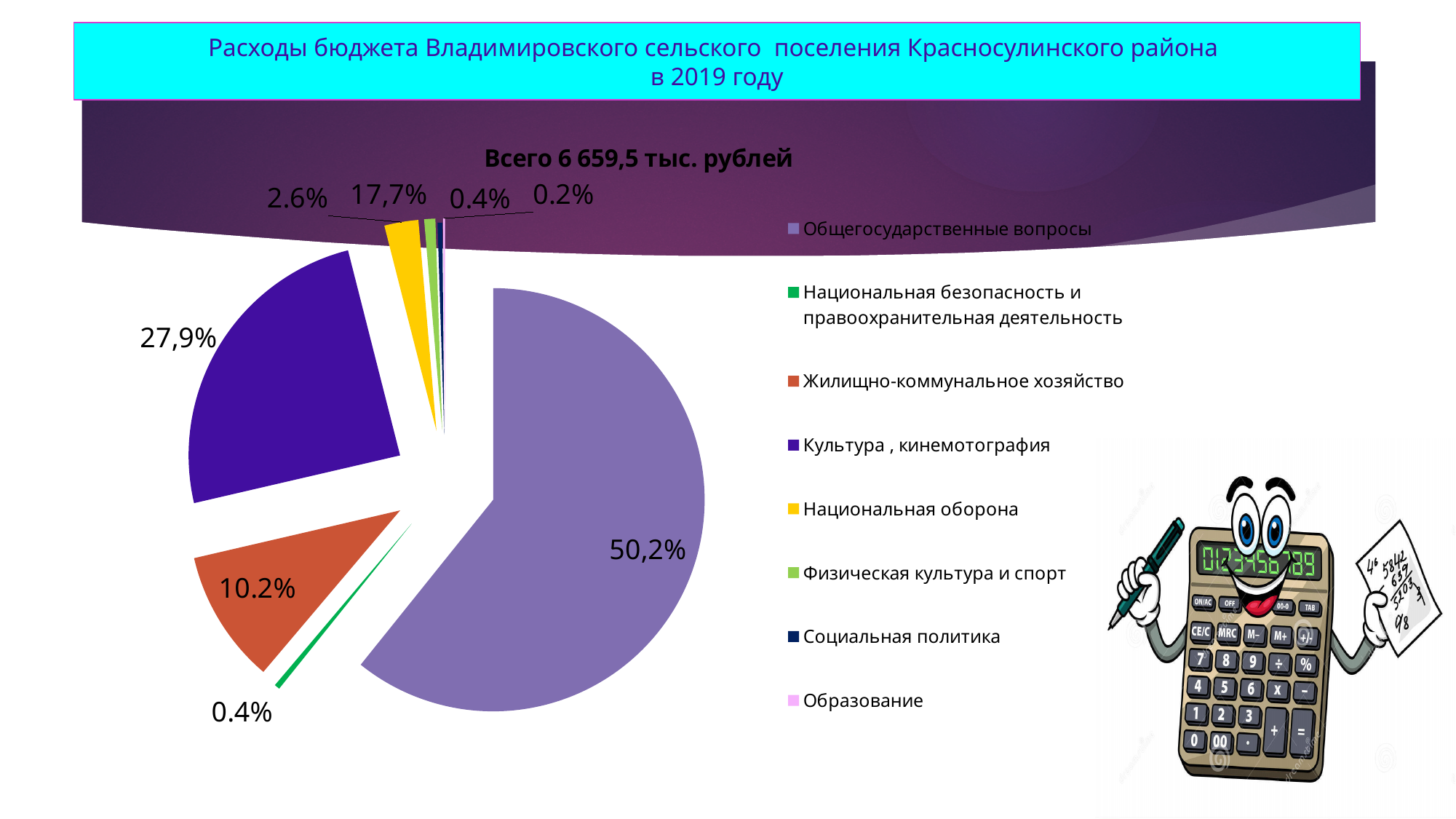
What total amount is stated above the chart? 6 659,5 тыс. рублей Which category has the largest share of the pie? Общегосударственные вопросы What kind of chart is shown on the slide? Pie chart What share of the pie does Культура , кинемотография take? 27,9% What is the difference in percentage points between the share for Общегосударственные вопросы and the share for Культура , кинемотография? 22,3 What share of the pie does Жилищно-коммунальное хозяйство take? 10.2% What share of the pie does Общегосударственные вопросы take? 50,2% Which legend entry is shown in yellow? Национальная оборона Which is larger: the share for Культура , кинемотография or the share for Жилищно-коммунальное хозяйство? Культура , кинемотография What is the difference in percentage points between the share for Культура , кинемотография and the share for Жилищно-коммунальное хозяйство? 17,7 Is the share for Общегосударственные вопросы greater or less than half of the pie? greater How many categories does the legend list? 8